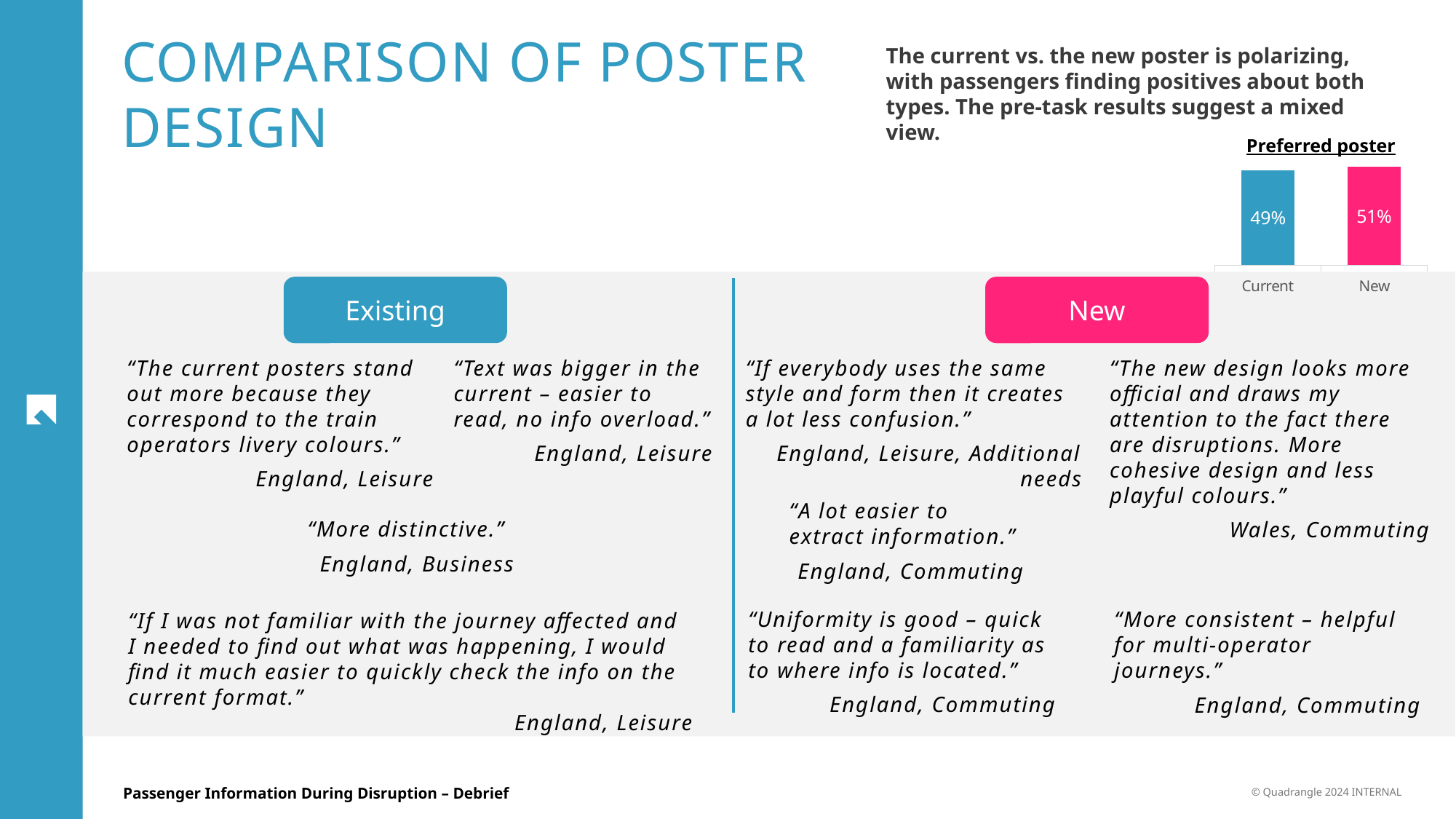
What kind of chart is the Preferred poster chart? Bar chart What is the title of the chart on the slide? Preferred poster What colour is the bar for the New poster in the Preferred poster chart? Pink What is the total of the Current and New percentages in the Preferred poster chart? 100% Is the value for the Current poster greater or less than the value for the New poster? less Which poster was preferred by the smaller share of passengers? Current What percentage of passengers preferred the Current poster? 49% Which poster was preferred by the larger share of passengers? New What percentage of passengers preferred the New poster? 51% What is the difference in percentage points between the New and Current poster preference? 2 percentage points How many categories are shown in the Preferred poster chart? 2